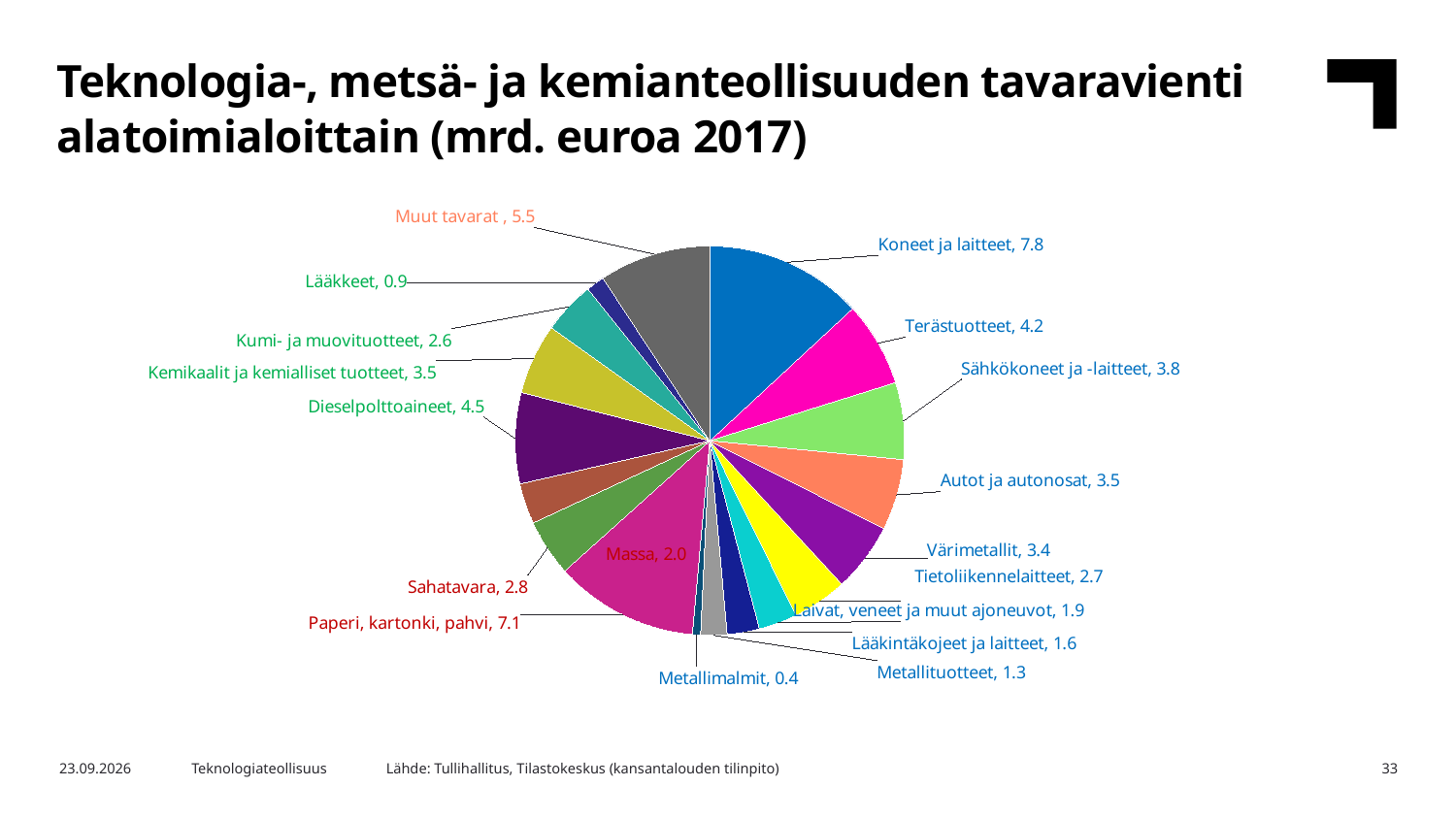
Which is larger, Terästuotteet or Dieselpolttoaineet? Dieselpolttoaineet What is the value for Paperi, kartonki, pahvi? 7.1 What type of chart is shown on the slide? Pie chart How many slices does the pie chart have? 18 What is the value for Dieselpolttoaineet? 4.5 What is the difference between the values for Muut tavarat and Sahatavara? 2.7 Which category has the largest slice in the pie chart? Koneet ja laitteet What is the title of the chart on the slide? Teknologia-, metsä- ja kemianteollisuuden tavaravienti alatoimialoittain (mrd. euroa 2017) Which category has the smallest slice in the pie chart? Metallimalmit What is the value for Metallimalmit? 0.4 What is the difference between the values for Koneet ja laitteet and Paperi, kartonki, pahvi? 0.7 What is the value for Koneet ja laitteet? 7.8